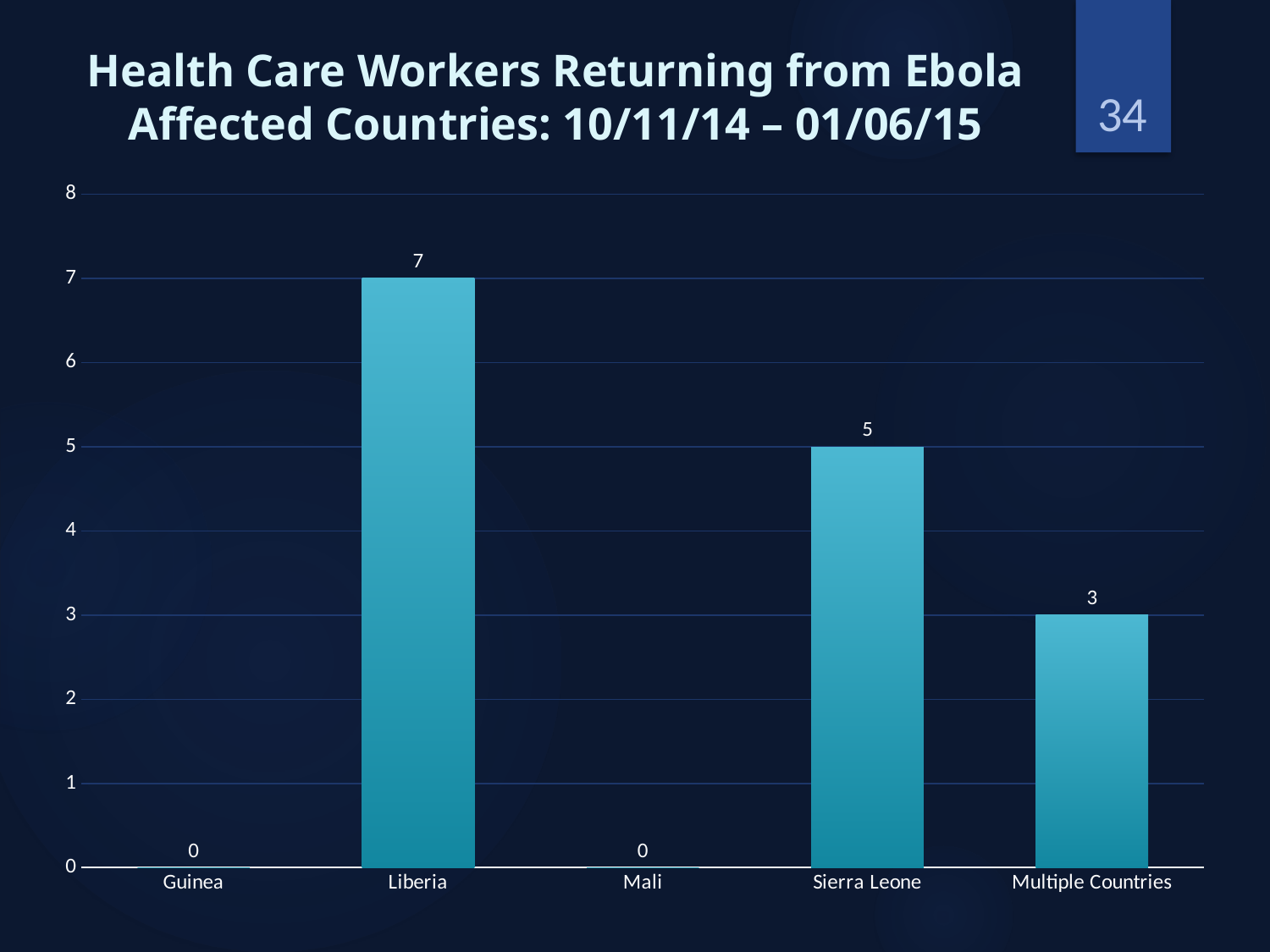
What is the value for Multiple Countries? 3 What is the value for Sierra Leone? 5 What kind of chart is shown on the slide? bar chart What is the value for Guinea? 0 What is the value for Liberia? 7 What is the difference between the values for Sierra Leone and Multiple Countries? 2 What is the difference between the values for Liberia and Sierra Leone? 2 What is the title of the chart? Health Care Workers Returning from Ebola Affected Countries: 10/11/14 – 01/06/15 Which is larger, the value for Sierra Leone or the value for Multiple Countries? Sierra Leone Is the value for Liberia greater or less than 6? greater Which category has the highest value? Liberia How many categories are shown on the x axis? 5